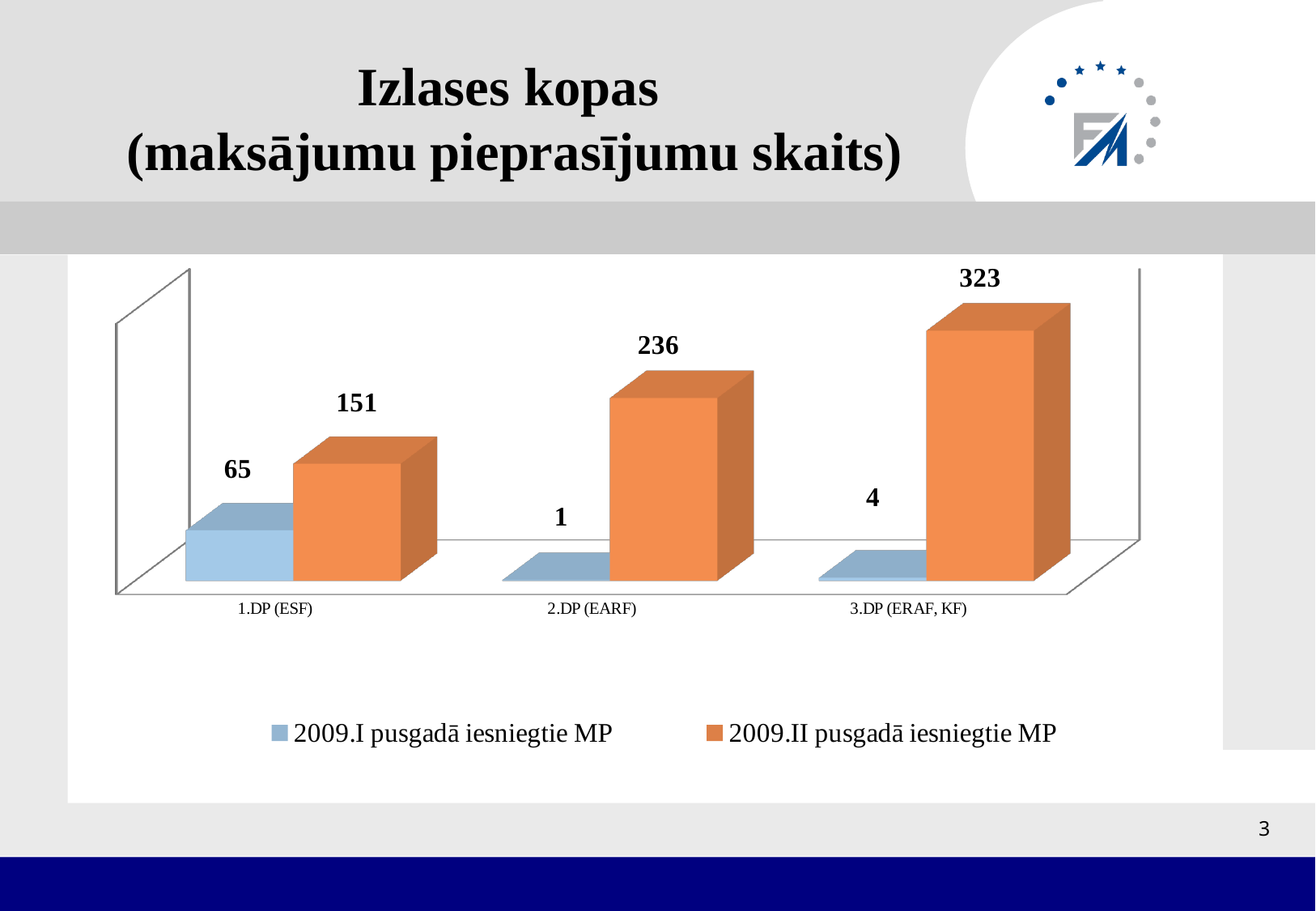
How many categories are shown on the x axis? 3 How many series does the legend list? 2 Which is larger: the 2009.II pusgadā value for 1.DP (ESF) or for 2.DP (EARF)? 2.DP (EARF) Which category has the highest value in the 2009.II pusgadā iesniegtie MP series? 3.DP (ERAF, KF) What kind of chart is shown on the slide? Bar chart What is the value for 2.DP (EARF) in the 2009.II pusgadā iesniegtie MP series? 236 What is the difference between the 2009.II pusgadā values for 3.DP (ERAF, KF) and 2.DP (EARF)? 87 What is the value for 3.DP (ERAF, KF) in the 2009.I pusgadā iesniegtie MP series? 4 Do the values of the 2009.II pusgadā iesniegtie MP series rise or fall from left to right along the x axis? Rise What is the value for 1.DP (ESF) in the 2009.I pusgadā iesniegtie MP series? 65 Which category has the lowest value in the 2009.I pusgadā iesniegtie MP series? 2.DP (EARF) What is the difference between the 2009.II pusgadā and 2009.I pusgadā values for 1.DP (ESF)? 86